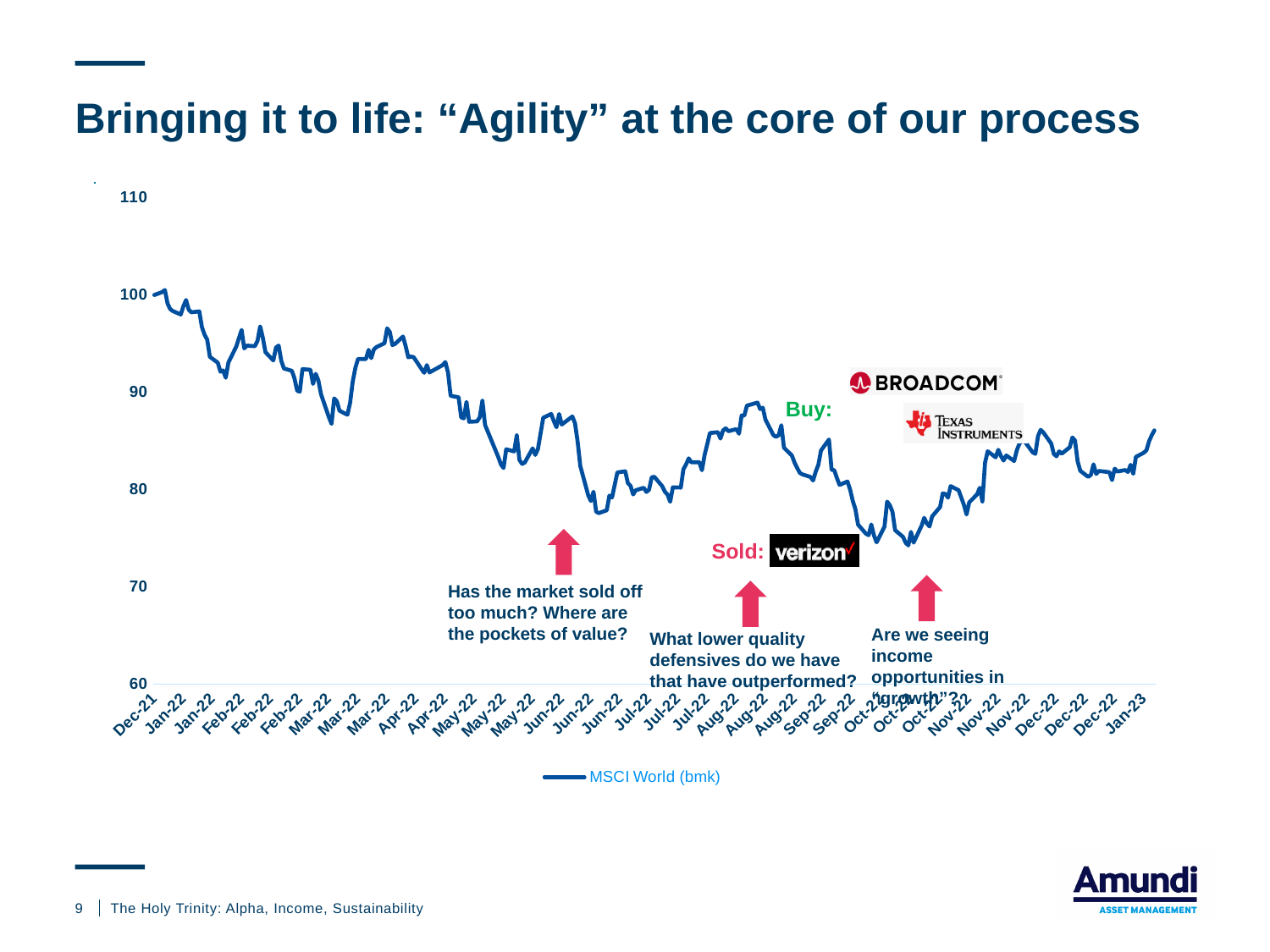
How many series does the legend list? 1 Is the lowest point of the MSCI World (bmk) line, around Oct-22, greater or less than 80? less Is the value of MSCI World (bmk) at the start of the chart (Dec-21) greater or less than 90? greater Is the value of MSCI World (bmk) at Dec-21 larger or smaller than its value at Jan-23? larger What is the highest value shown on the vertical axis? 110 What is the name of the series shown in the legend? MSCI World (bmk) Does the MSCI World (bmk) line rise or fall between Dec-21 and Jun-22? fall Is the value of MSCI World (bmk) at the end of the chart (Jan-23) greater or less than 90? less What kind of chart is shown on the slide? line chart Does the MSCI World (bmk) line rise or fall between Oct-22 and Jan-23? rise